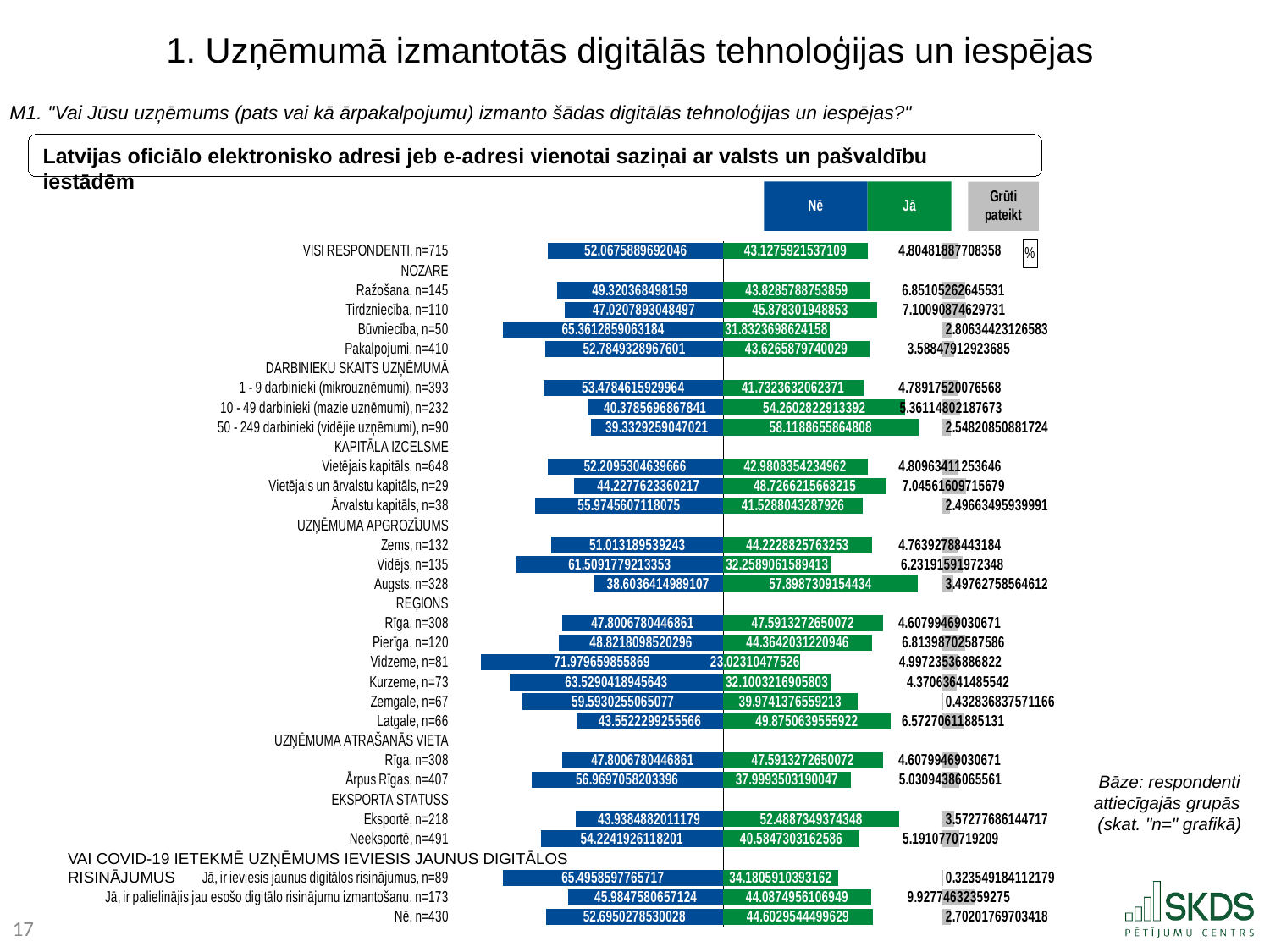
What kind of chart is shown on the slide? Stacked horizontal bar chart Which category has the lowest value in the "Jā" series? Vidzeme, n=81 Which category has the lowest value in the "Grūti pateikt" series? Jā, ir ieviesis jaunus digitālos risinājumus, n=89 How many series does the legend list? 3 What is the value of the "Nē" series for "VISI RESPONDENTI, n=715"? 52.0675889692046 Which colour represents the "Jā" series in the chart? Green What is the value of the "Grūti pateikt" series for "Tirdzniecība, n=110"? 7.10090874629731 Which category has the highest value in the "Grūti pateikt" series? Jā, ir palielinājis jau esošo digitālo risinājumu izmantošanu, n=173 For "50 - 249 darbinieki (vidējie uzņēmumi), n=90", which is larger: the "Nē" value or the "Jā" value? Jā Which category has the highest value in the "Nē" series? Vidzeme, n=81 For "Būvniecība, n=50", which is larger: the "Nē" value or the "Jā" value? Nē What is the value of the "Jā" series for "Augsts, n=328"? 57.8987309154434